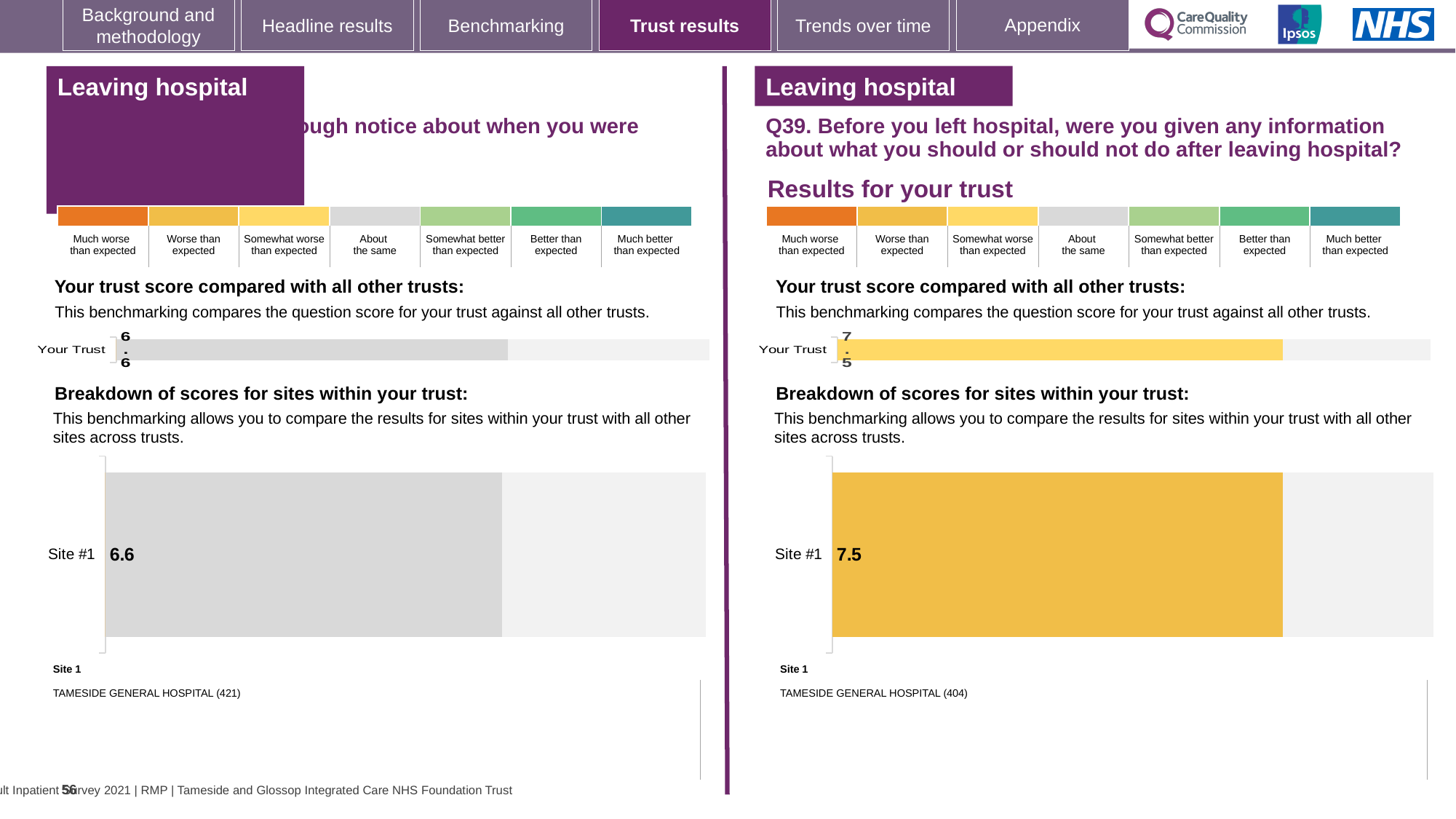
On the left-hand panel, what is the score shown for Site #1? 6.6 How many sites are shown in the site breakdown chart on the left-hand panel? 1 Which is larger: the Site #1 score on the left-hand panel or the Site #1 score on the right-hand panel (Q39)? Right-hand panel (Q39) On the right-hand panel (Q39), what is the score shown for Your Trust? 7.5 What is the difference between the Site #1 score on the right-hand panel (Q39) and the Site #1 score on the left-hand panel? 0.9 On the left-hand panel, which site name is listed as Site 1? TAMESIDE GENERAL HOSPITAL (421) Is the Your Trust score on the right-hand panel (Q39) greater or less than 7? greater On the right-hand panel (Q39), what is the score shown for Site #1? 7.5 Is the Your Trust score on the left-hand panel greater or less than 7? less What type of chart is used to show the Site #1 score on the right-hand panel (Q39)? Bar chart On the left-hand panel, what is the score shown for Your Trust? 6.6 On the right-hand panel (Q39), which site name is listed as Site 1? TAMESIDE GENERAL HOSPITAL (404)